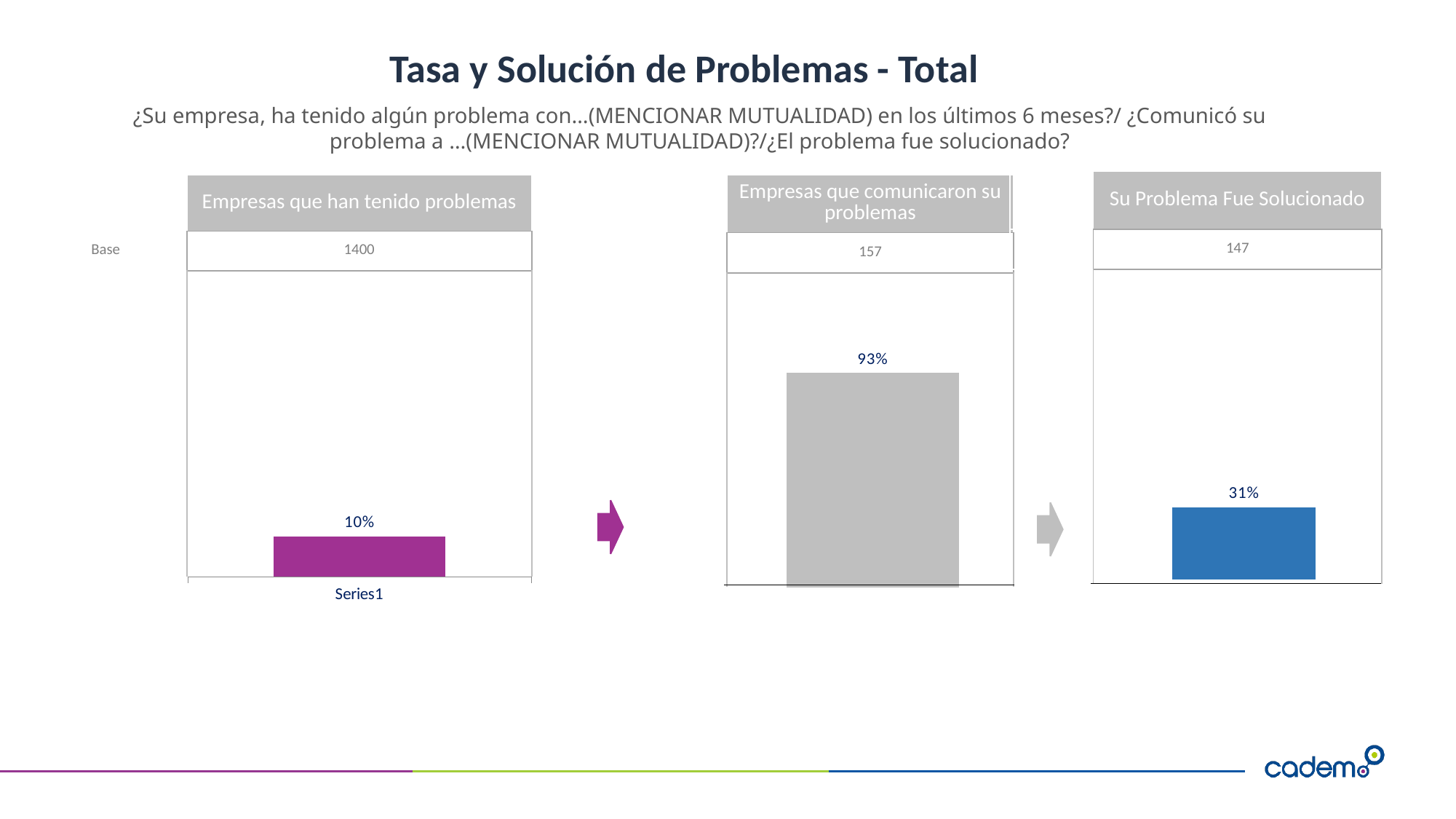
In the chart titled 'Empresas que han tenido problemas', what value is shown on the bar? 10% What is the base shown above the chart 'Su Problema Fue Solucionado'? 147 What is the category label shown under the bar in the chart 'Empresas que han tenido problemas'? Series1 What is the base shown above the chart 'Empresas que han tenido problemas'? 1400 What is the base shown above the chart 'Empresas que comunicaron su problemas'? 157 Is the value in the chart 'Su Problema Fue Solucionado' larger or smaller than the value in the chart 'Empresas que han tenido problemas'? larger Which of the three charts on the slide shows the highest percentage? Empresas que comunicaron su problemas What kind of chart is used in the chart titled 'Empresas que han tenido problemas'? bar chart In the chart titled 'Empresas que comunicaron su problemas', what value is shown on the bar? 93% What is the difference between the value in the chart 'Empresas que comunicaron su problemas' and the value in the chart 'Su Problema Fue Solucionado'? 62% Which of the three charts on the slide shows the lowest percentage? Empresas que han tenido problemas In the chart titled 'Su Problema Fue Solucionado', what value is shown on the bar? 31%